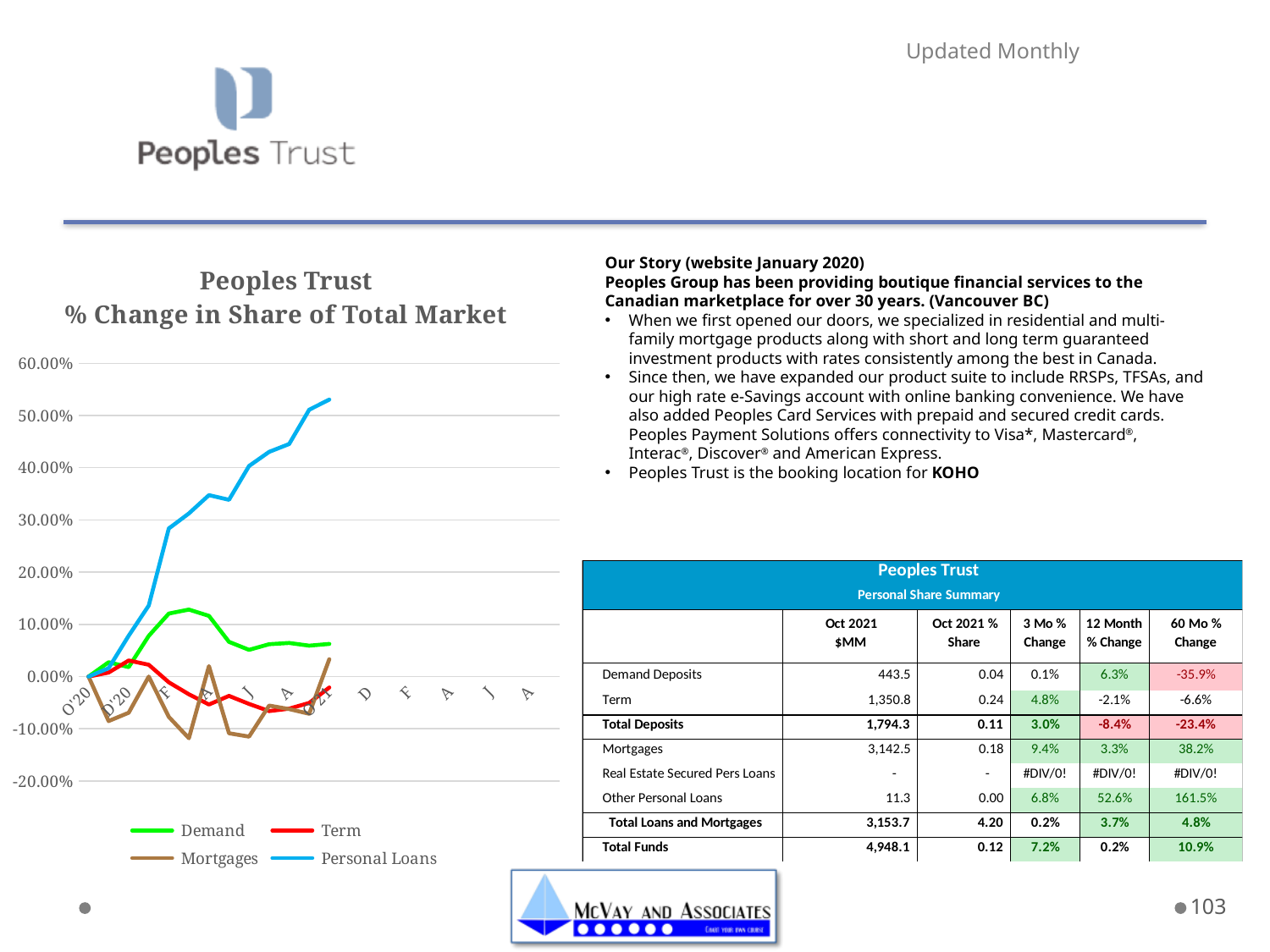
Which colour is used for the Personal Loans line? blue Is the peak value of the Demand line greater or less than 20.00%? less Is the lowest value of the Mortgages line greater or less than 0.00%? less What is the title of the chart? Peoples Trust % Change in Share of Total Market How many series does the chart legend list? 4 Does the Personal Loans line generally rise or fall along the x axis? rise What kind of chart is shown on the slide? line chart What is the highest value shown on the vertical axis? 60.00% At the end of the plotted data, which is larger: the Personal Loans value or the Demand value? Personal Loans Which series reaches the highest value on the chart? Personal Loans Is the final value of the Personal Loans line greater or less than 50.00%? greater Which series reaches the lowest value on the chart? Mortgages